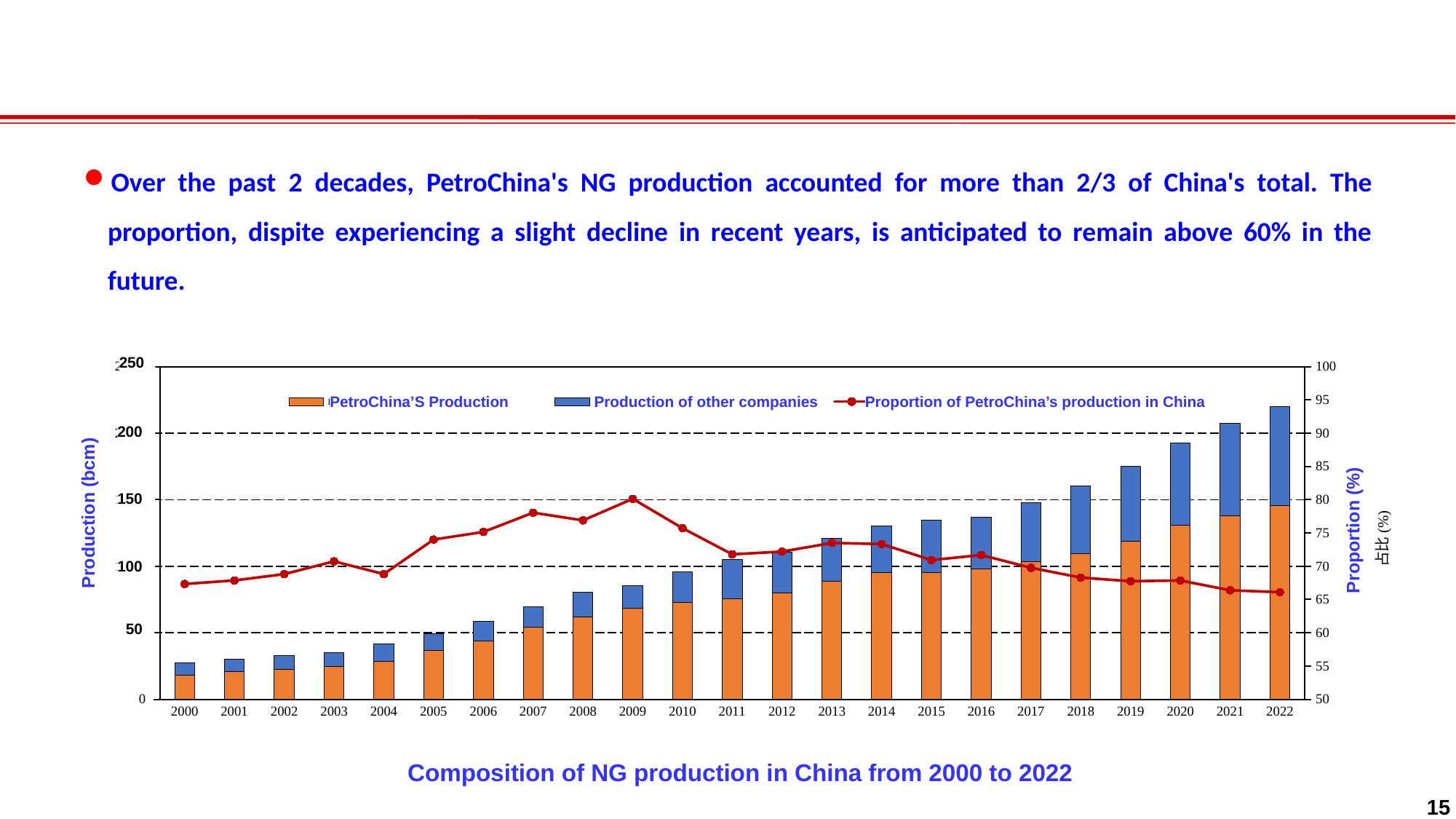
How many years are shown along the x axis of the chart? 23 In which year is the proportion of PetroChina's production in China highest? 2009 In which year is the total NG production (full stacked bar) lowest? 2000 In which year is the total NG production (full stacked bar) highest? 2022 In 2022, which is larger: PetroChina's production or the production of other companies? PetroChina's production Is the proportion of PetroChina's production in China in 2022 greater or less than 70%? less What kind of chart is shown on the slide? A bar chart combined with a line chart What is the label of the left vertical axis? Production (bcm) How many series does the chart's legend list? 3 Does the total NG production rise or fall from 2000 to 2022? rise What is the title of the chart? Composition of NG production in China from 2000 to 2022 Is PetroChina's production in 2022 greater or less than 100 bcm? greater